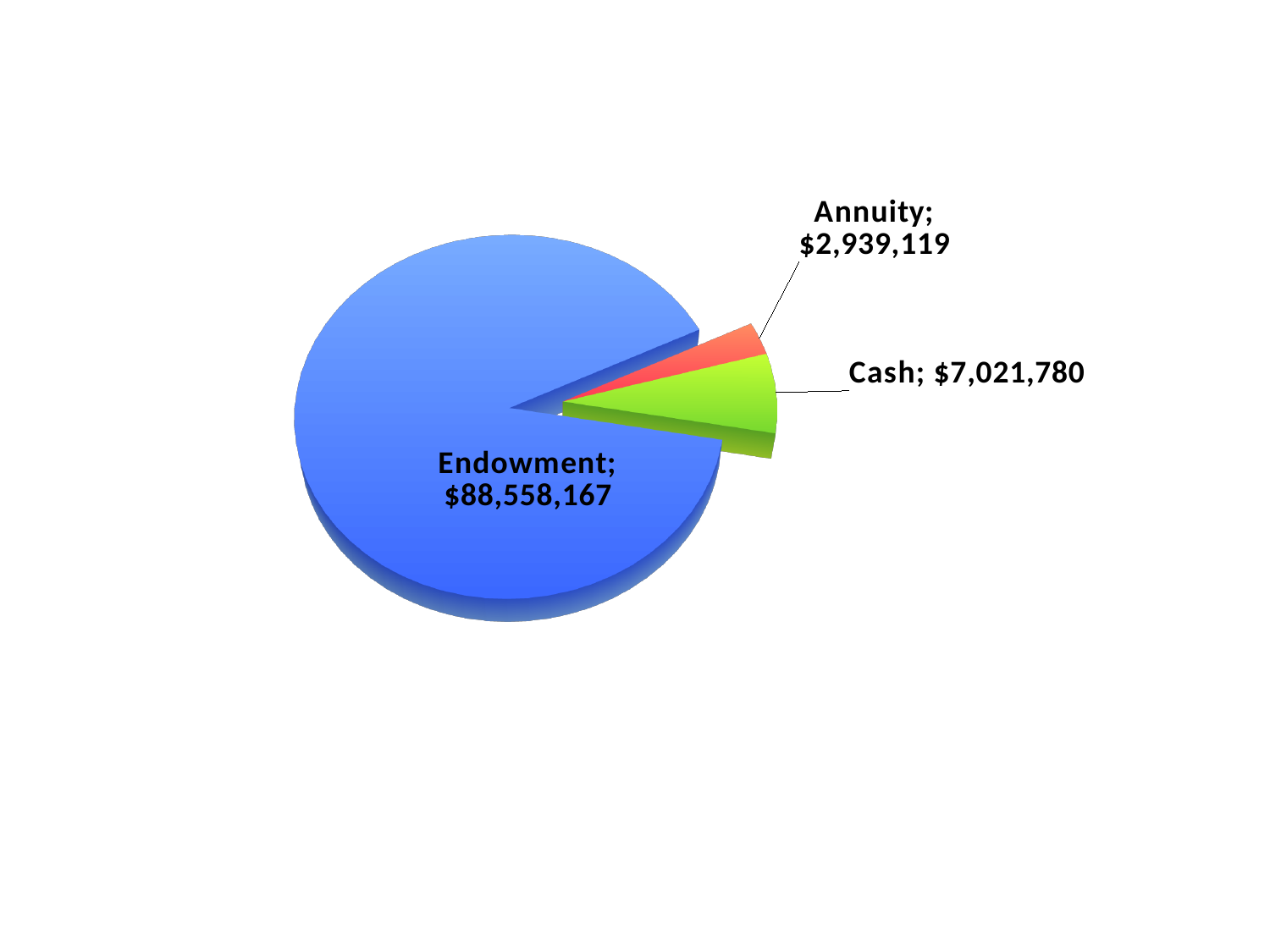
What is the value for Annuity? $2,939,119 How many slices does the pie chart have? 3 What is the total of all three slices? $98,519,066 What colour is the Endowment slice? Blue What is the value for Endowment? $88,558,167 Which is larger, Cash or Annuity? Cash What is the value for Cash? $7,021,780 Which category has the largest slice? Endowment What is the difference between the Endowment and Cash values? $81,536,387 What kind of chart is shown on the slide? Pie chart What is the difference between the Cash and Annuity values? $4,082,661 Which category has the smallest slice? Annuity